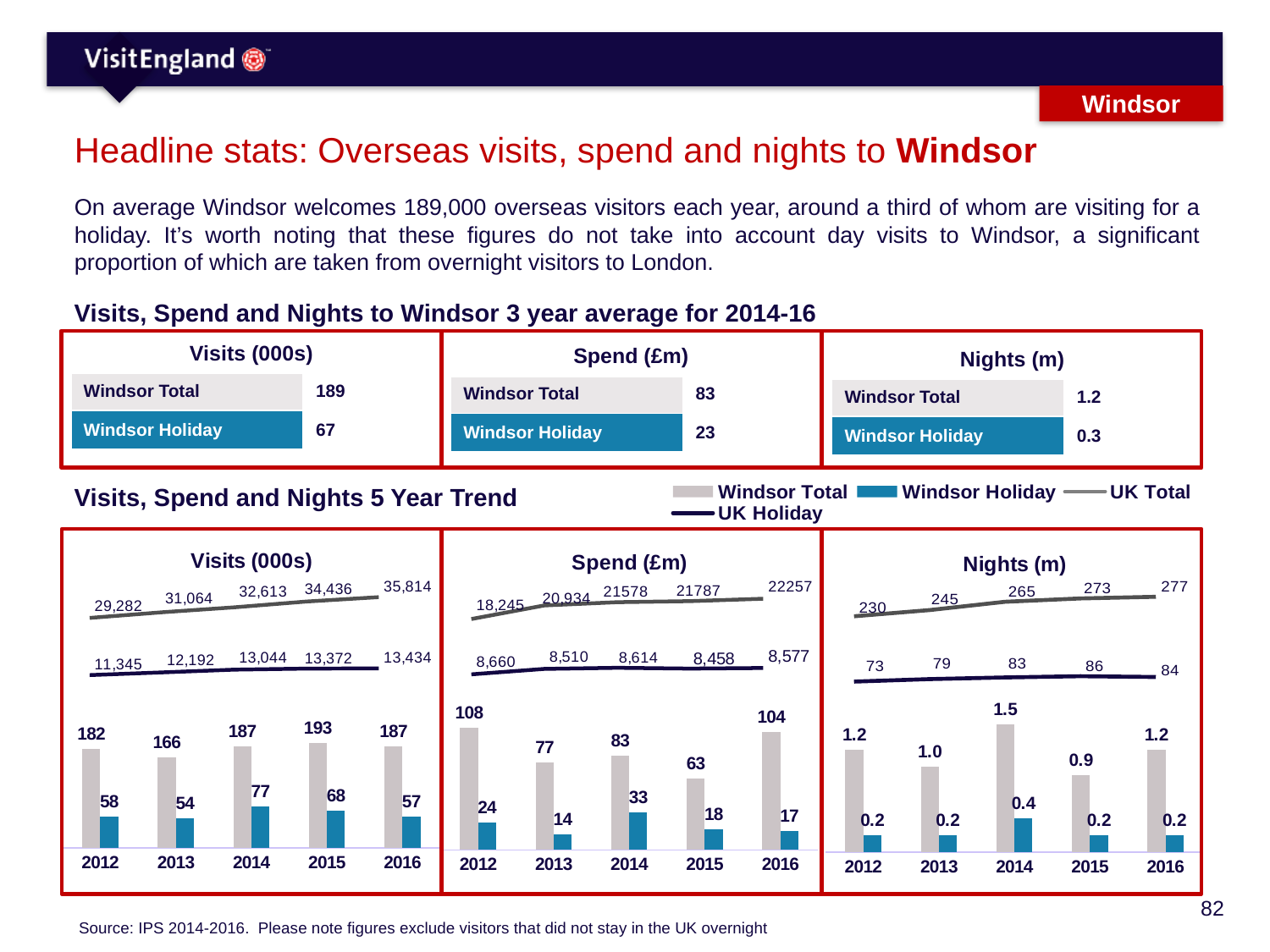
In the Nights (m) chart, what is the Windsor Total value for 2014? 1.5 In the Visits (000s) chart, what is the UK Holiday value for 2012? 11,345 In the Nights (m) chart, what is the UK Total value for 2016? 277 In the Spend (£m) chart, which year has the lowest Windsor Holiday value? 2013 In the Spend (£m) chart, which year has the highest Windsor Total value? 2012 In the Nights (m) chart, does the UK Total line rise or fall from 2012 to 2016? rise In the Visits (000s) chart, what is the difference between the Windsor Total values for 2015 and 2013? 27 How many years are shown on the x axis of the Spend (£m) chart? 5 In the Visits (000s) chart, what is the Windsor Total value for 2015? 193 In the Spend (£m) chart, is the Windsor Total value for 2016 larger or smaller than the value for 2015? larger How many series does the legend above the 5 Year Trend charts list? 4 In the Visits (000s) chart, what is the Windsor Holiday value for 2014? 77